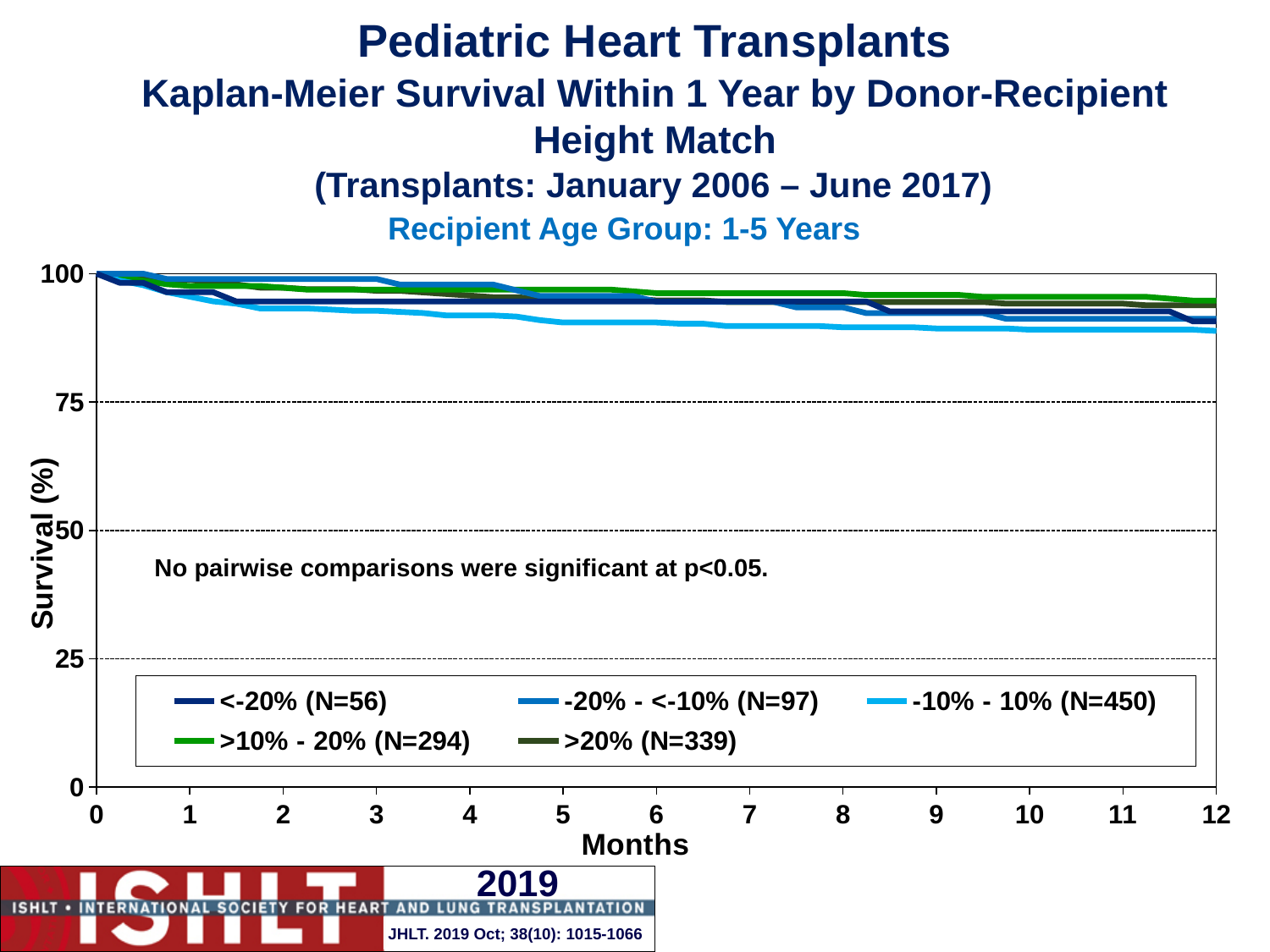
What is the sample size (N) for the >20% height match group? 339 What kind of chart is shown on the slide? Line chart What is the sample size (N) for the -10% - 10% height match group? 450 Which group has the lowest survival at 12 months? -10% - 10% (N=450) Which height match group has the largest sample size (N)? -10% - 10% (N=450) Is the survival value for the -10% - 10% group at 12 months greater or less than 75? greater Do the survival curves rise or fall as months increase? Fall What is the label of the y-axis? Survival (%) How many series does the legend list? 5 Which height match group has the smallest sample size (N)? <-20% (N=56) What is the difference in sample size between the -10% - 10% group and the <-20% group? 394 What is the sample size (N) for the <-20% height match group? 56